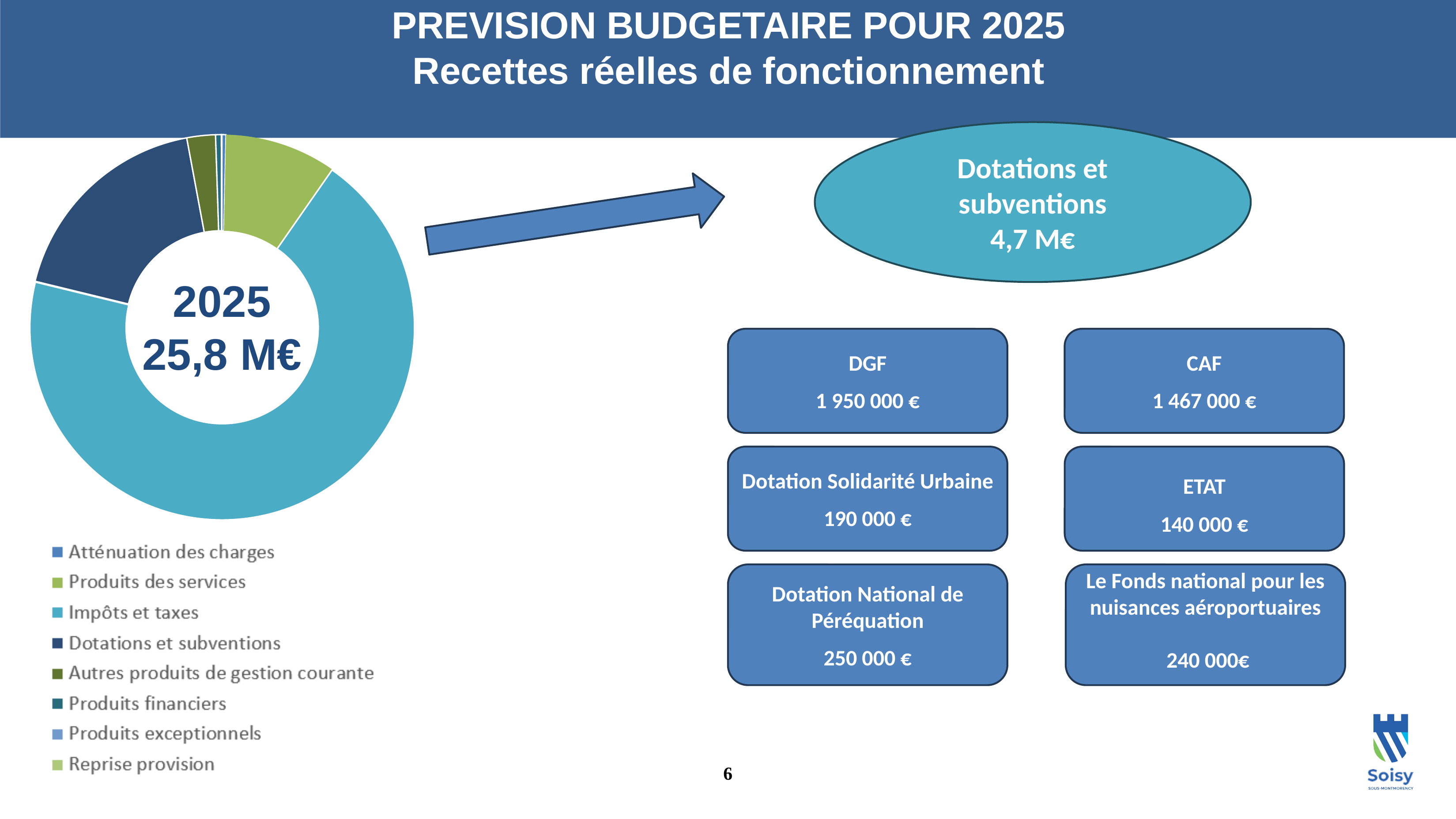
What kind of chart is shown on the left of the slide? Pie (donut) chart How many categories does the legend of the pie chart list? 8 Which slice is larger in the pie chart: Dotations et subventions or Produits des services? Dotations et subventions What year is printed in the centre of the pie chart? 2025 Which category has the largest slice in the pie chart? Impôts et taxes What value is given on the slide for the Dotations et subventions slice of the pie chart? 4,7 M€ What is the last category listed in the pie chart's legend? Reprise provision What total amount is printed in the centre of the pie chart? 25,8 M€ Which slice is larger in the pie chart: Impôts et taxes or Dotations et subventions? Impôts et taxes Which slice is larger in the pie chart: Produits des services or Autres produits de gestion courante? Produits des services What is the first category listed in the pie chart's legend? Atténuation des charges